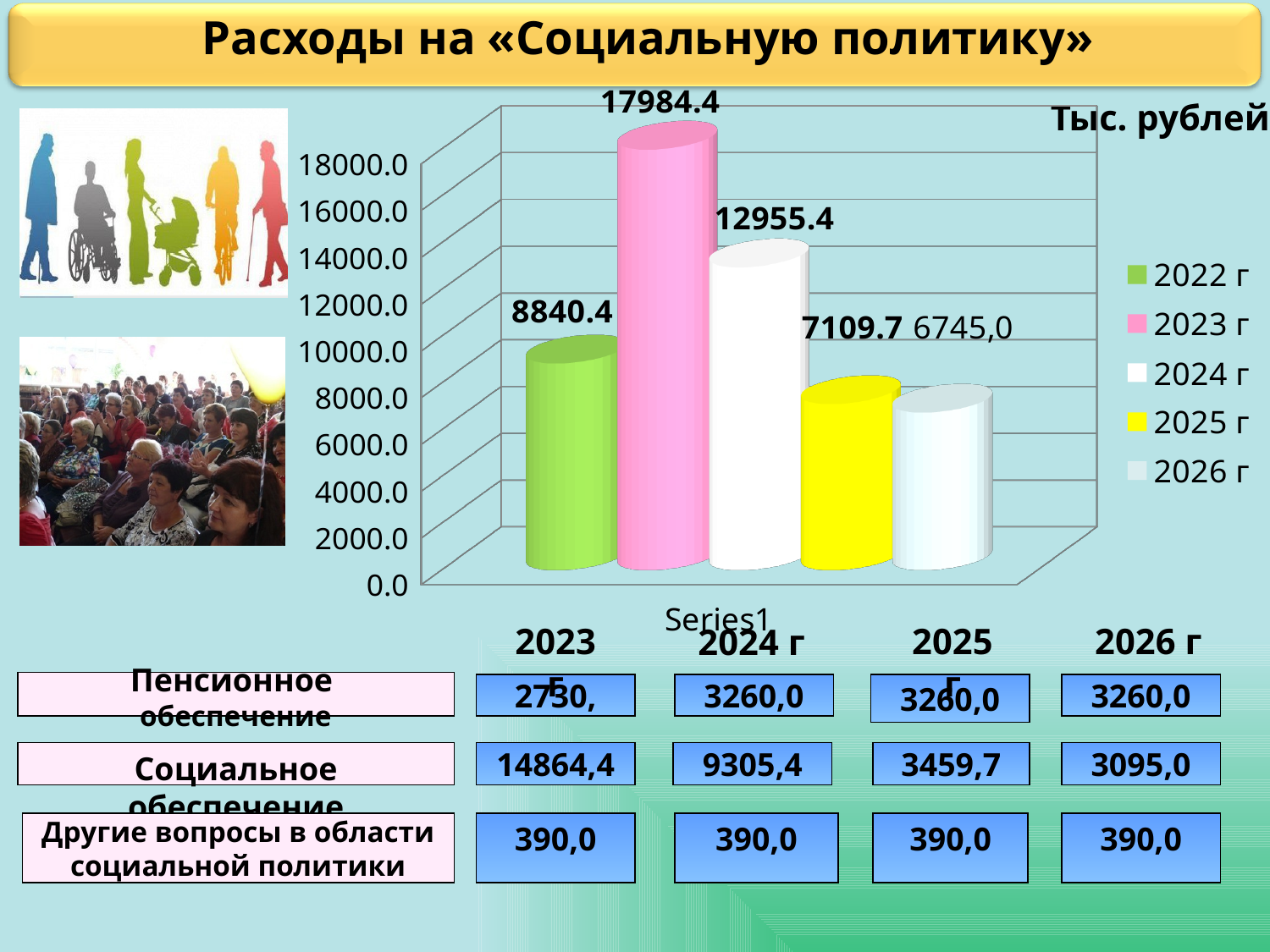
Which year has the highest value in the chart? 2023 г What is the value for 2025 г in the chart? 7109.7 Which year has the lowest value in the chart? 2026 г What is the value for 2023 г in the chart? 17984.4 How many series does the legend list? 5 What is the value for 2024 г in the chart? 12955.4 What is the difference between the values for 2023 г and 2024 г? 5029.0 Which is larger, the value for 2022 г or the value for 2025 г? 2022 г What is the value for 2022 г in the chart? 8840.4 Is the value for 2026 г greater or less than 8000.0? less What unit is indicated for the chart values? Тыс. рублей What kind of chart is shown on the slide? bar chart